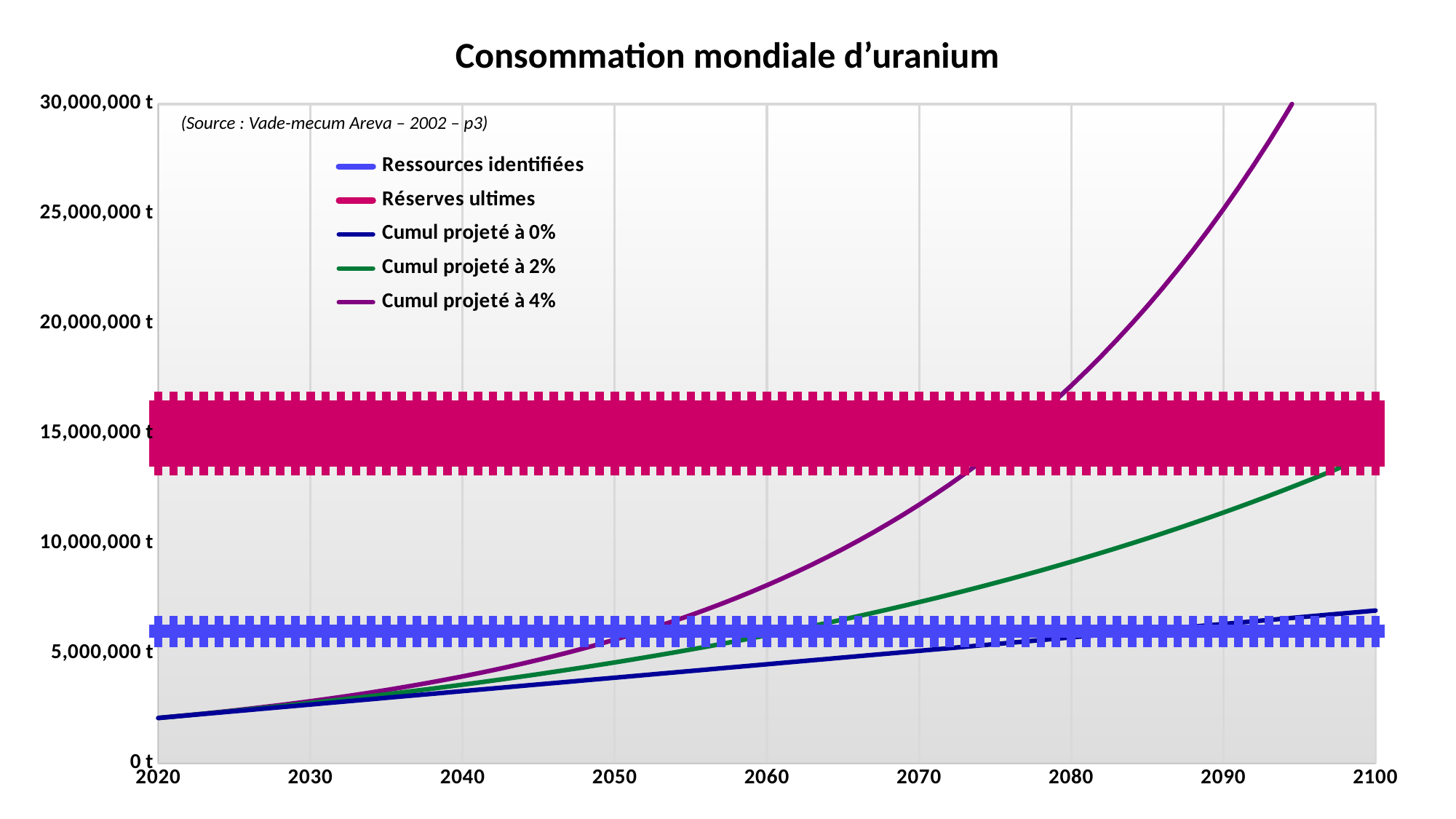
Is the value of Cumul projeté à 0% in 2100 greater or less than 10,000,000 t? less At 2090, which is larger: Cumul projeté à 4% or Cumul projeté à 2%? Cumul projeté à 4% What is the title of the chart? Consommation mondiale d'uranium How many series does the legend list? 5 Does the Cumul projeté à 2% series rise or fall from 2020 to 2100? rise Is the value of Cumul projeté à 0% in 2020 greater or less than 5,000,000 t? less Is the value of Cumul projeté à 2% in 2100 greater or less than 15,000,000 t? less What kind of chart is shown on the slide? line chart Which of the three 'Cumul projeté' series has the lowest value at 2100? Cumul projeté à 0% Which series has the highest value at 2090? Cumul projeté à 4% What source is cited on the chart? Vade-mecum Areva – 2002 – p3